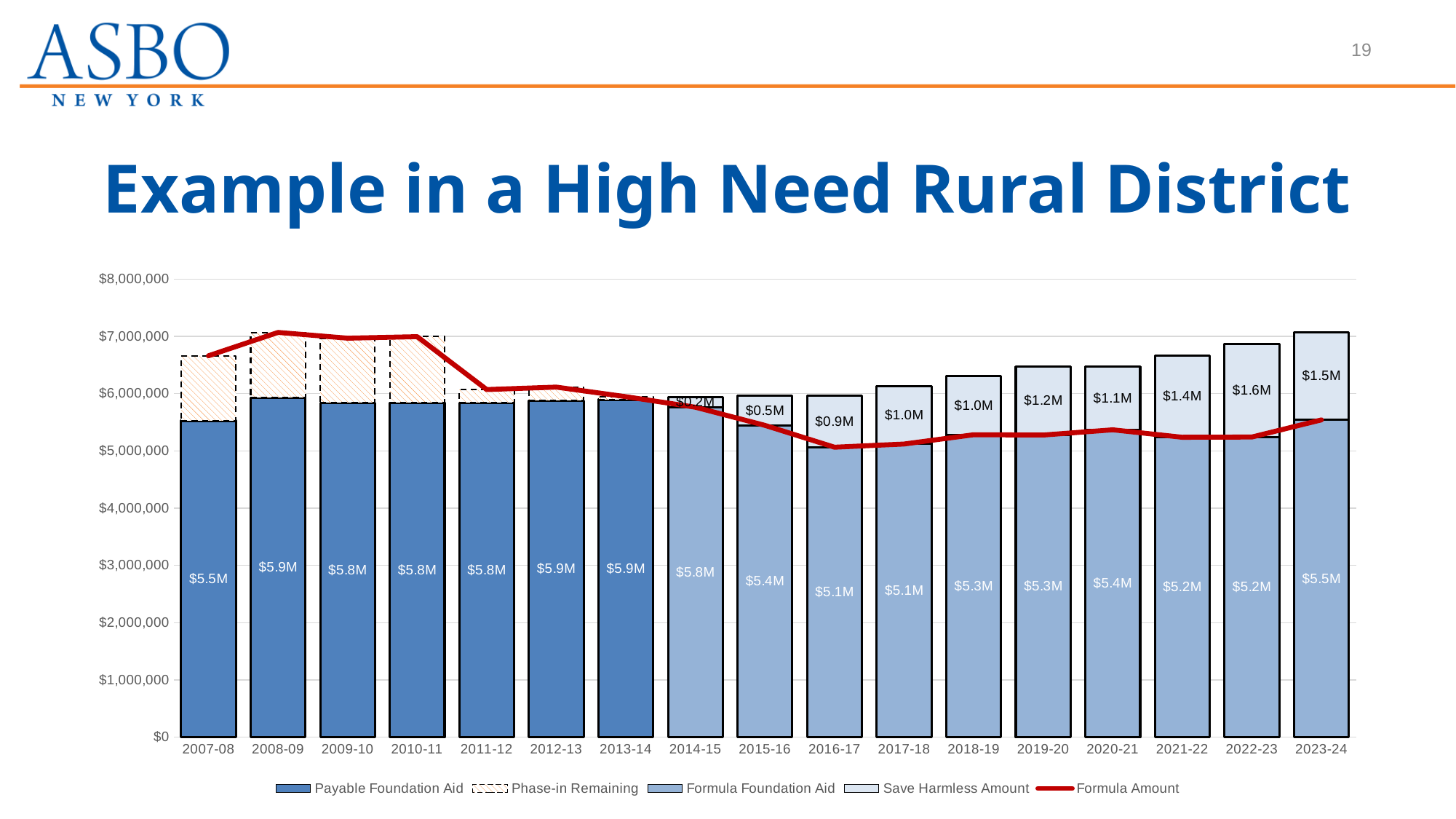
How many series does the legend list? 5 What kind of chart is shown on the slide? Stacked bar chart with a line Which year has the lowest Save Harmless Amount? 2014-15 What is the Save Harmless Amount for 2022-23? $1.6M What is the difference between the Save Harmless Amount in 2022-23 and in 2015-16? $1.1M Does the Formula Amount line rise or fall from 2010-11 to 2016-17? Fall What is the Formula Foundation Aid value for 2016-17? $5.1M How many fiscal years are shown on the x axis? 17 Is the Formula Amount line value for 2007-08 greater or less than $6,000,000? greater What is the Payable Foundation Aid value for 2007-08? $5.5M Which is larger, the Formula Foundation Aid in 2014-15 or in 2023-24? 2014-15 Which year has the highest Save Harmless Amount? 2022-23